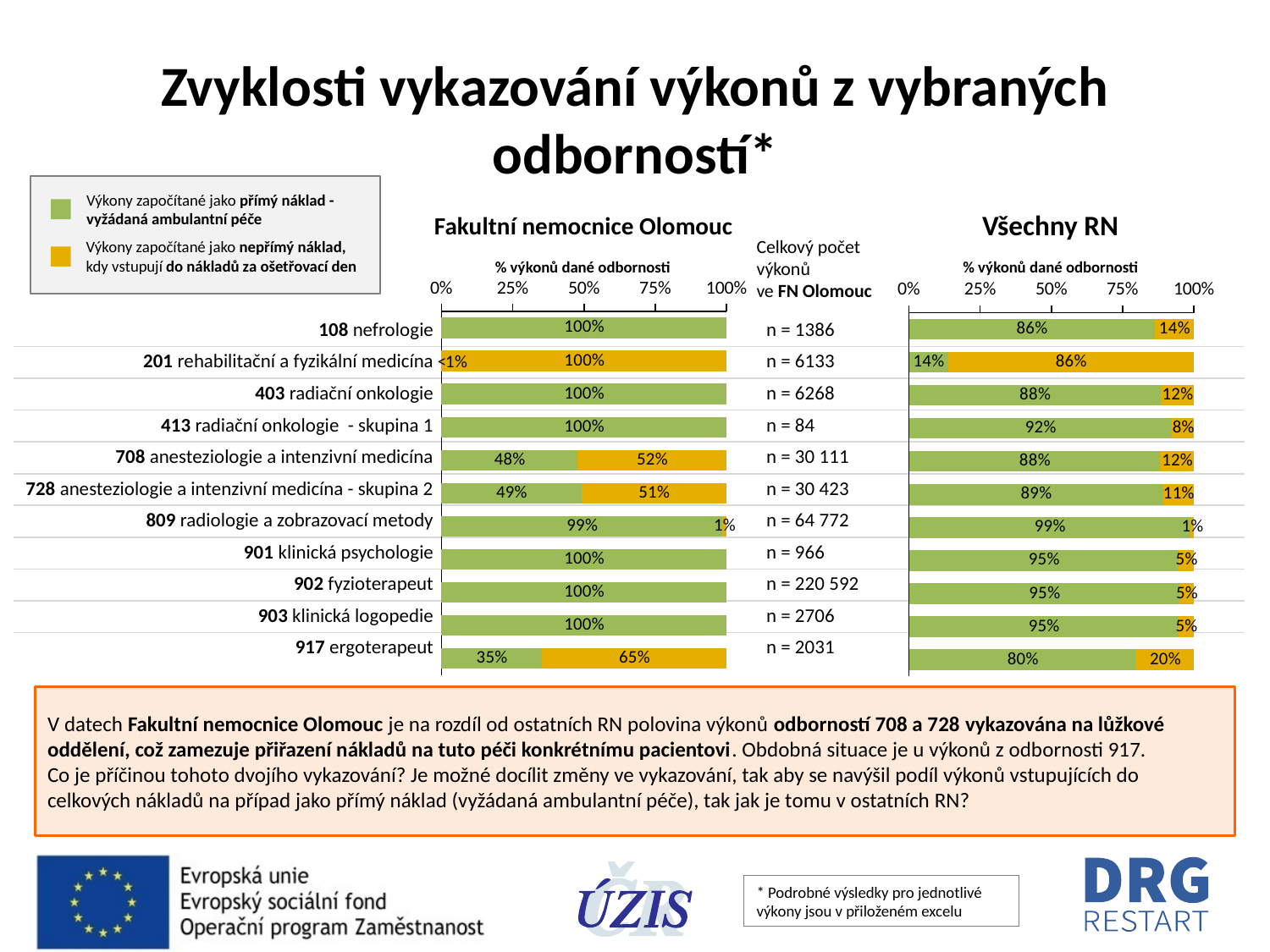
In the Fakultní nemocnice Olomouc chart, what percentage of procedures for 708 anesteziologie a intenzivní medicína is counted as direct cost (green)? 48% How many specialties (categories) are shown in the Fakultní nemocnice Olomouc chart? 11 In the Fakultní nemocnice Olomouc chart, by how many percentage points does the orange share exceed the green share for 917 ergoterapeut? 30 percentage points How many series does the legend list for the charts? 2 Which colour represents procedures counted as direct cost (vyžádaná ambulantní péče) in the legend? Green In the Všechny RN chart, which has the larger green share: 413 radiační onkologie - skupina 1 or 403 radiační onkologie? 413 radiační onkologie - skupina 1 What type of chart is the Všechny RN chart? Stacked bar chart In the Fakultní nemocnice Olomouc chart, which specialty has the lowest green (direct cost) share? 201 rehabilitační a fyzikální medicína In the Fakultní nemocnice Olomouc chart, what is the orange (indirect cost) share for 917 ergoterapeut? 65% In the Všechny RN chart, which specialty has the highest green (direct cost) share? 809 radiologie a zobrazovací metody What is the total number of procedures (n) for 902 fyzioterapeut in FN Olomouc? n = 220 592 In the Všechny RN chart, what percentage of procedures for 917 ergoterapeut is counted as indirect cost (orange)? 20%